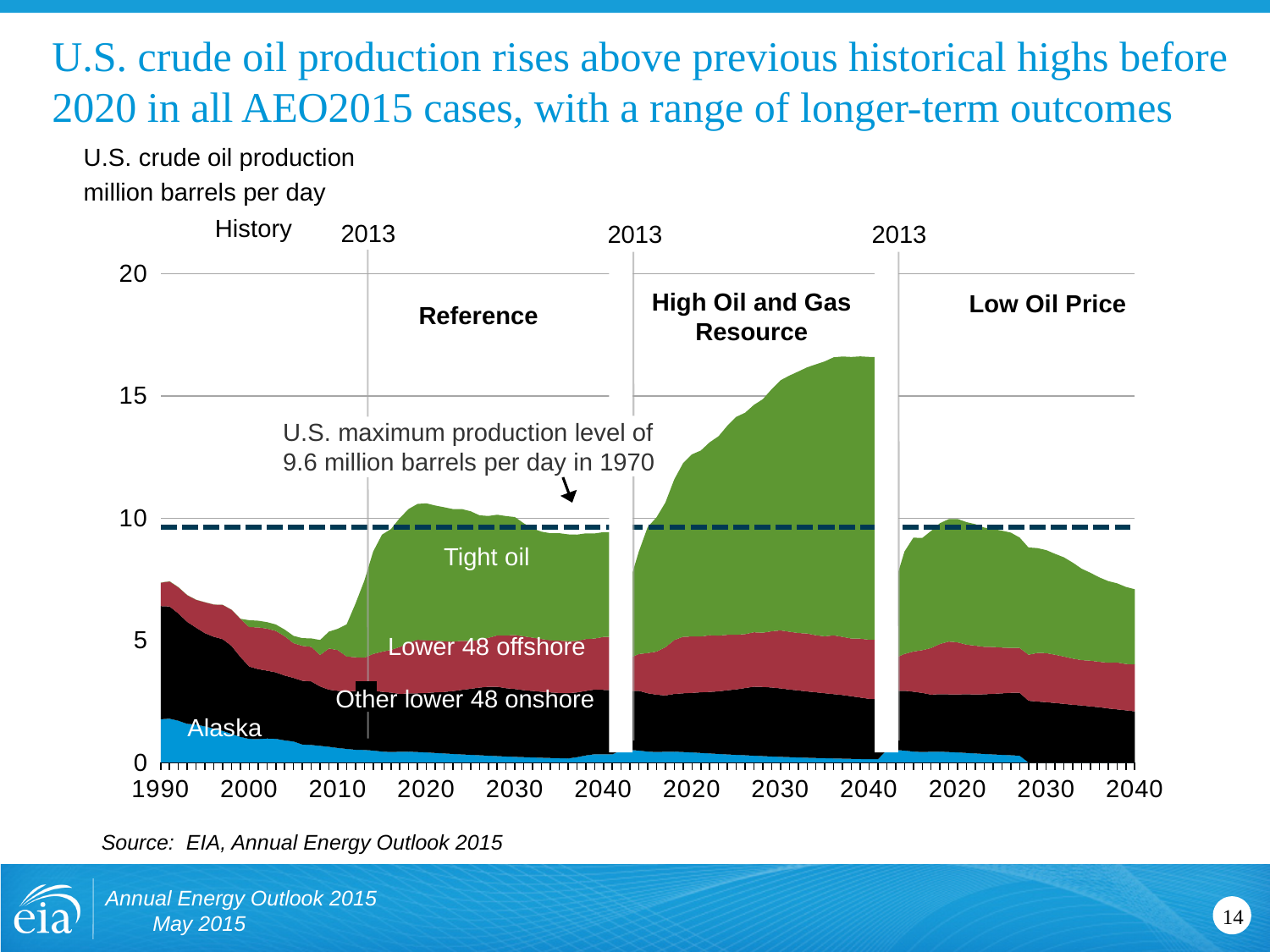
Which case shows the highest total crude oil production in 2040? High Oil and Gas Resource What U.S. maximum production level is noted on the chart, and in what year was it reached? 9.6 million barrels per day in 1970 What kind of chart is shown on the slide? Stacked area chart In the Reference panel, is total crude oil production in 2040 greater or less than 10 million barrels per day? less In the Low Oil Price panel, is total crude oil production in 2040 greater or less than 10 million barrels per day? less How many production components (series) are labeled in the chart? 4 In the Low Oil Price panel, does total production rise or fall from 2020 to 2040? fall In the High Oil and Gas Resource panel, is total crude oil production in 2040 greater or less than 15 million barrels per day? greater How many AEO2015 projection cases are shown as separate panels in the chart? 3 What unit is used for the y-axis of the chart? million barrels per day In the High Oil and Gas Resource panel, does total production rise or fall from 2013 to 2040? rise Which case shows the lowest total crude oil production in 2040? Low Oil Price